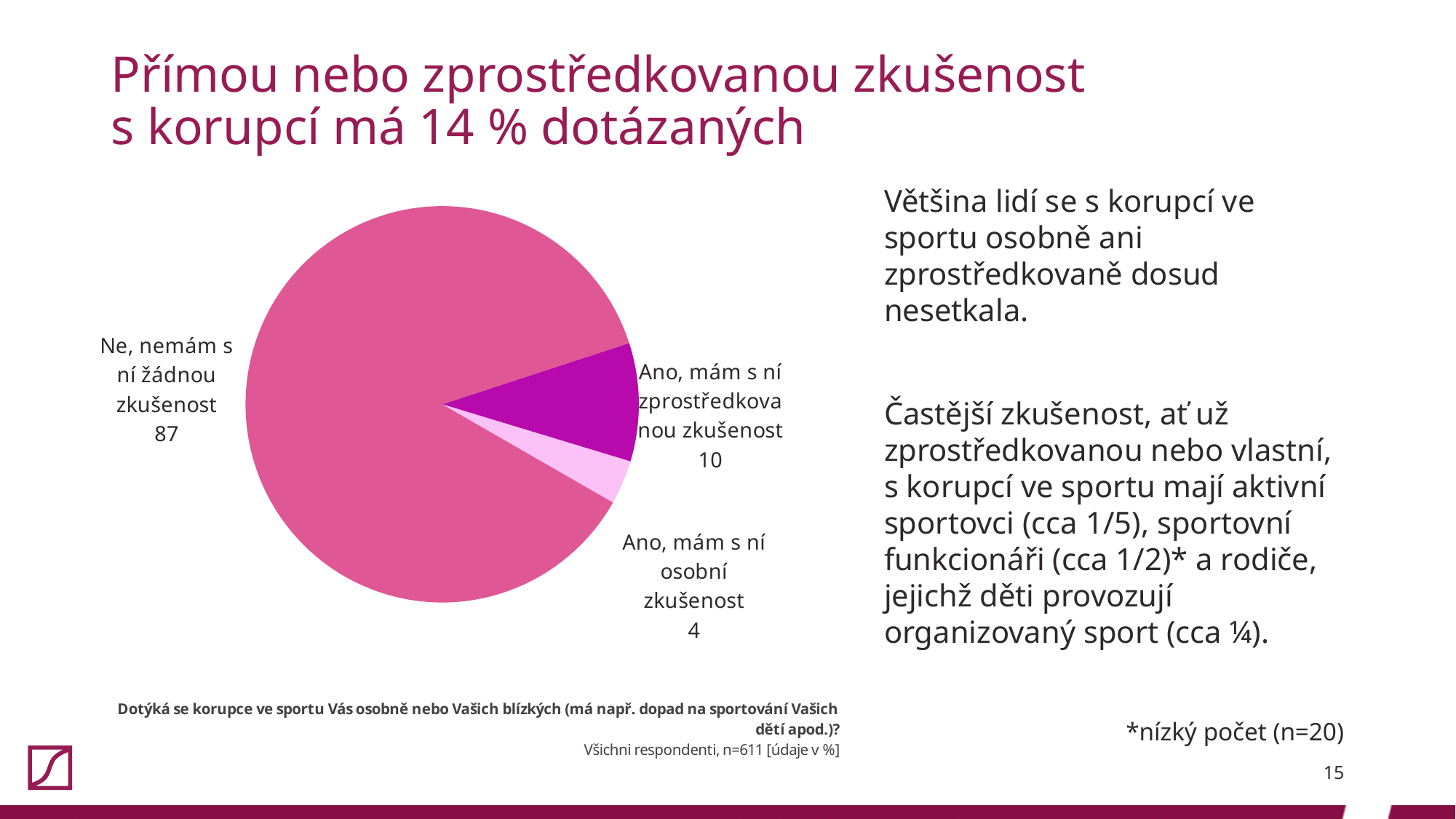
What is the difference between the values for "Ano, mám s ní zprostředkovanou zkušenost" and "Ano, mám s ní osobní zkušenost"? 6 What is the value for "Ano, mám s ní zprostředkovanou zkušenost"? 10 Which category has the largest slice of the pie? Ne, nemám s ní žádnou zkušenost What is the value for "Ano, mám s ní osobní zkušenost"? 4 According to the footnote, how many respondents does the chart cover? n=611 What is the combined value of the two "Ano" slices? 14 What kind of chart is shown on the slide? pie chart How many categories does the pie chart show? 3 Which is larger: the value for "Ano, mám s ní zprostředkovanou zkušenost" or for "Ano, mám s ní osobní zkušenost"? Ano, mám s ní zprostředkovanou zkušenost Which category has the smallest slice of the pie? Ano, mám s ní osobní zkušenost What is the difference between the values for "Ne, nemám s ní žádnou zkušenost" and "Ano, mám s ní zprostředkovanou zkušenost"? 77 What is the value for "Ne, nemám s ní žádnou zkušenost"? 87